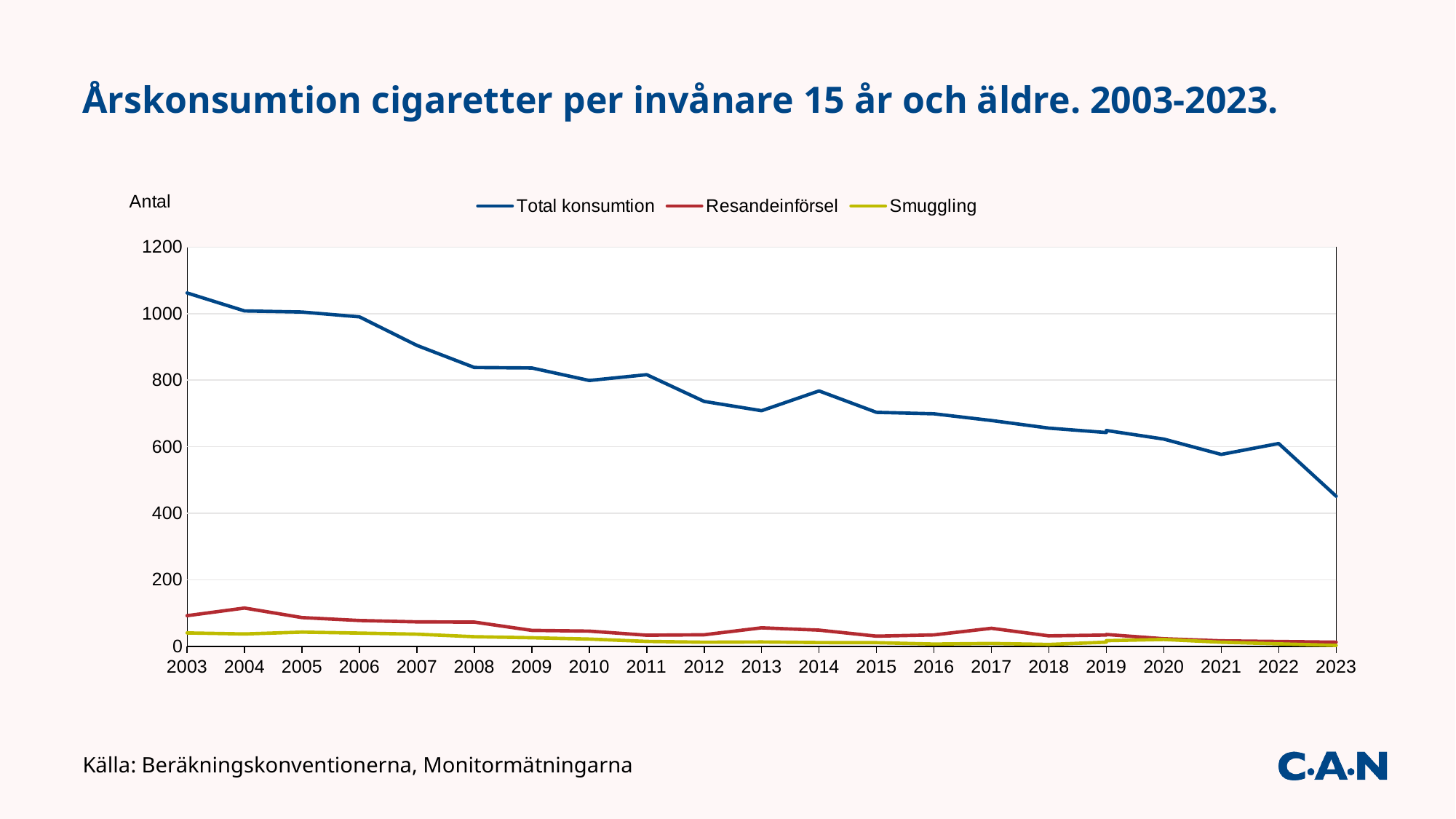
Is the value for Total konsumtion in 2003 greater or less than 1000? greater Does the Total konsumtion line generally rise or fall from 2003 to 2023? Fall In which year is Total konsumtion highest? 2003 How many years are plotted along the x axis? 21 In which year is Total konsumtion lowest? 2023 In 2010, which is larger: Total konsumtion or Resandeinförsel? Total konsumtion In which year is Resandeinförsel highest? 2004 How many series does the legend list? 3 Is the value for Resandeinförsel in 2004 greater or less than 200? less What is the title of the chart? Årskonsumtion cigaretter per invånare 15 år och äldre. 2003-2023. What kind of chart is shown on the slide? Line chart Is the value for Total konsumtion in 2023 greater or less than 600? less